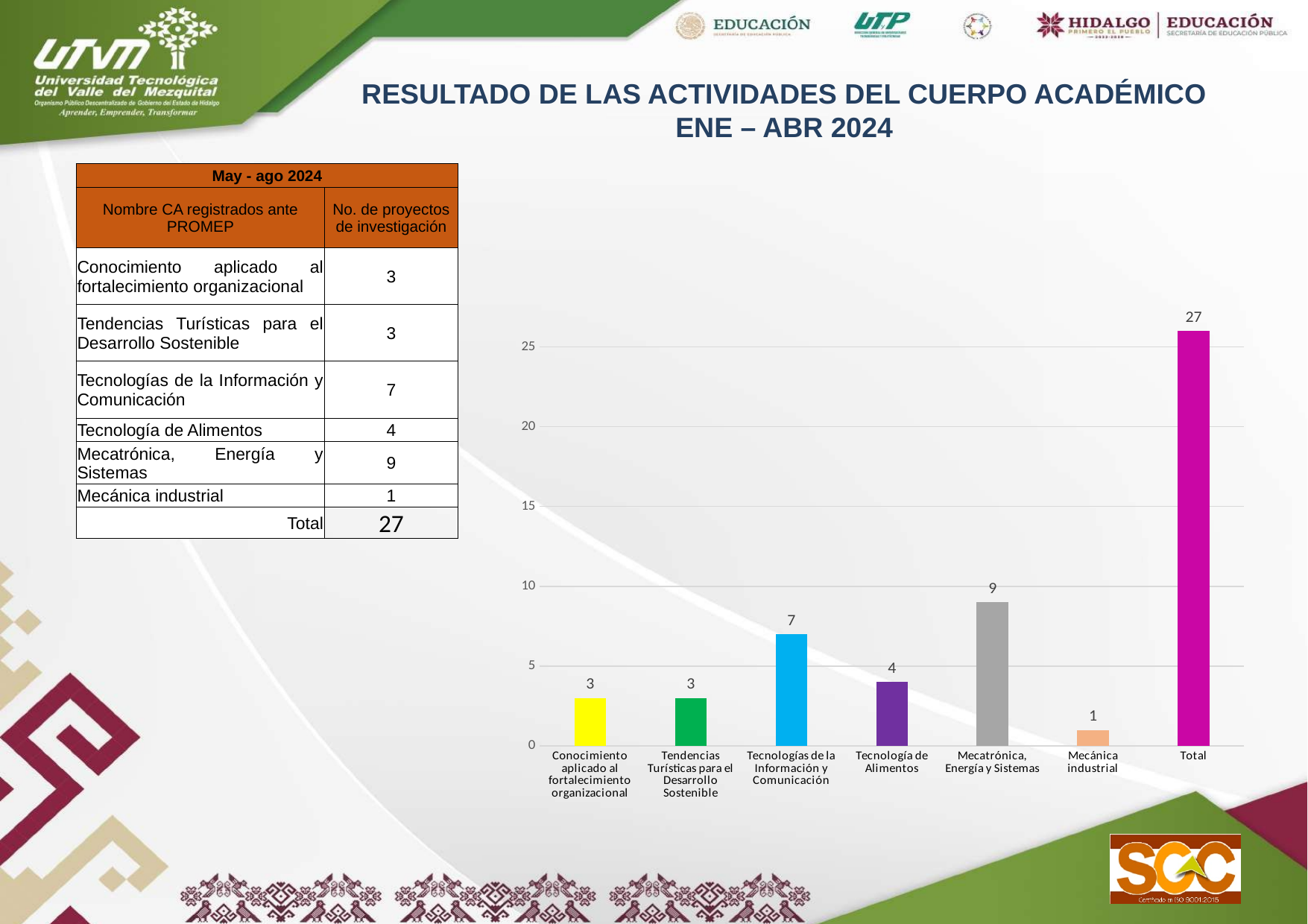
Which category has the lowest value in the bar chart? Mecánica industrial What is the difference between the values for Mecatrónica, Energía y Sistemas and Tecnología de Alimentos? 5 What is the value for Mecatrónica, Energía y Sistemas in the bar chart? 9 What is the value for Mecánica industrial in the bar chart? 1 Which is larger: the value for Tecnologías de la Información y Comunicación or the value for Tecnología de Alimentos? Tecnologías de la Información y Comunicación What is the value for Tecnologías de la Información y Comunicación in the bar chart? 7 How many bars are shown in the chart, including the Total bar? 7 Excluding the Total bar, which category has the highest value in the bar chart? Mecatrónica, Energía y Sistemas What kind of chart is shown on the slide? bar chart Is the value for the Total bar greater or less than 25? greater What colour is the Total bar in the chart? magenta What is the value of the Total bar in the chart? 27